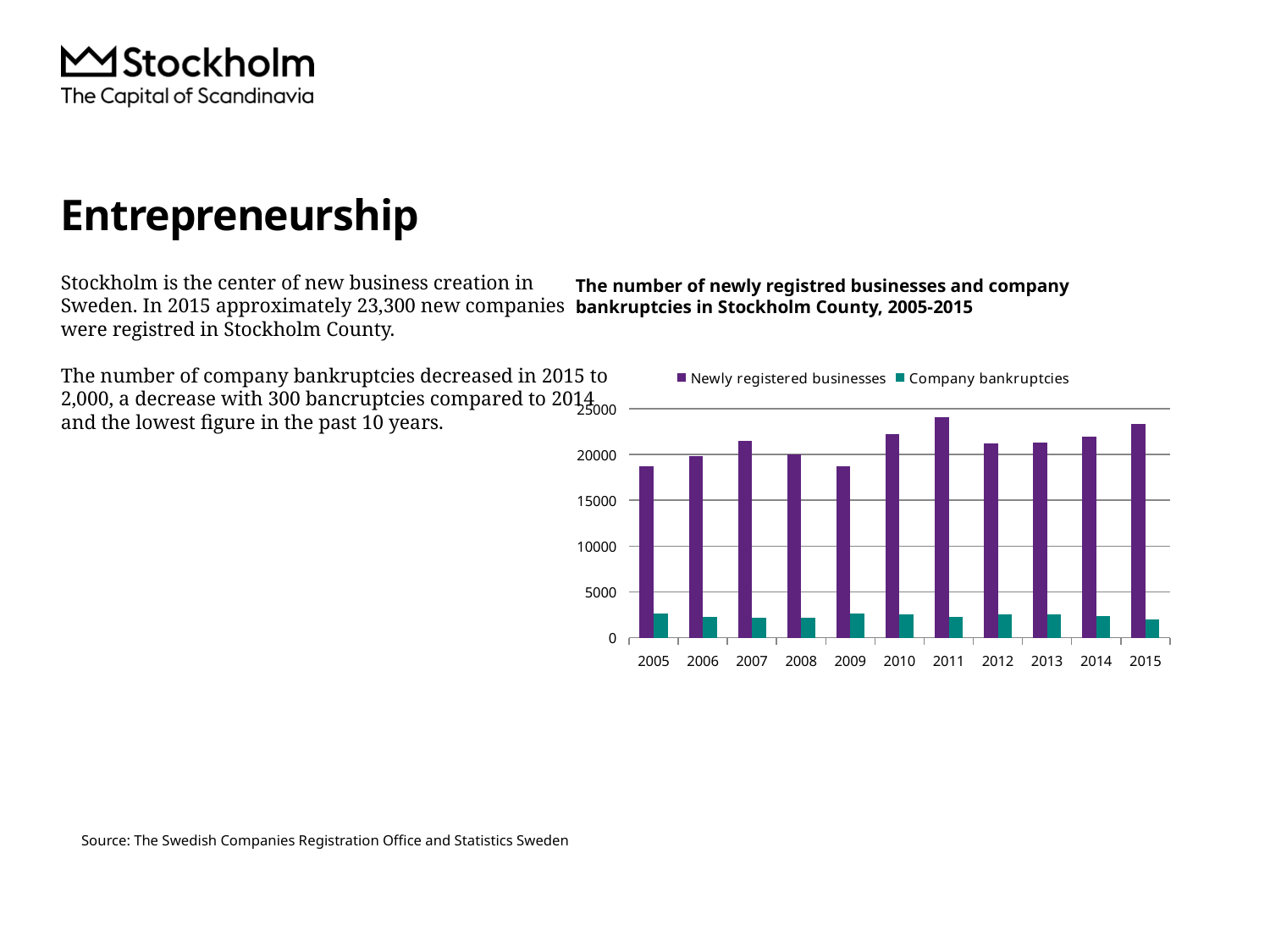
How many series does the chart's legend list? 2 How many years are shown on the x axis of the chart? 11 Did the number of newly registered businesses rise or fall from 2009 to 2011? rise In which year was the number of newly registered businesses highest? 2011 Which year had more newly registered businesses, 2009 or 2011? 2011 Is the number of newly registered businesses in 2011 greater or less than 20000? greater Which year had more newly registered businesses, 2007 or 2008? 2007 Which series is shown in purple in the chart? Newly registered businesses What kind of chart is shown on the slide? Bar chart Is the number of company bankruptcies in 2010 greater or less than 5000? less Is the number of newly registered businesses in 2005 greater or less than 20000? less What is the title of the chart? The number of newly registred businesses and company bankruptcies in Stockholm County, 2005-2015